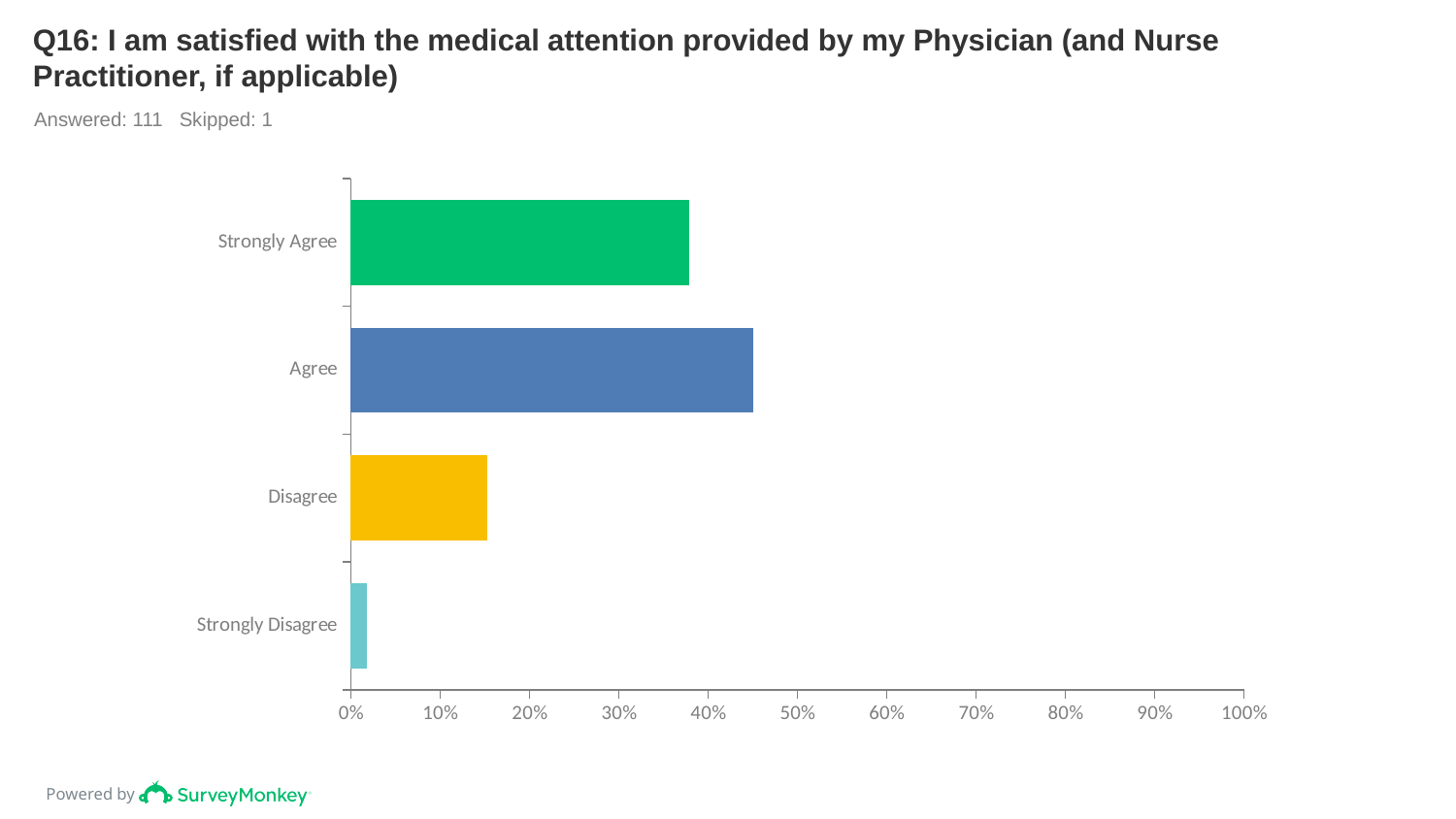
How many respondents answered this question according to the slide? 111 Which is larger, the value for Disagree or the value for Strongly Disagree? Disagree Which category has the lowest value? Strongly Disagree Is the value for Agree greater or less than 40%? greater What is the highest value shown on the x axis of the chart? 100% Is the value for Strongly Agree greater or less than 40%? less Is the value for Disagree greater or less than 20%? less How many categories are plotted in the chart? 4 What kind of chart is shown on the slide? bar chart Which category has the highest value? Agree Which is larger, the value for Strongly Agree or the value for Agree? Agree